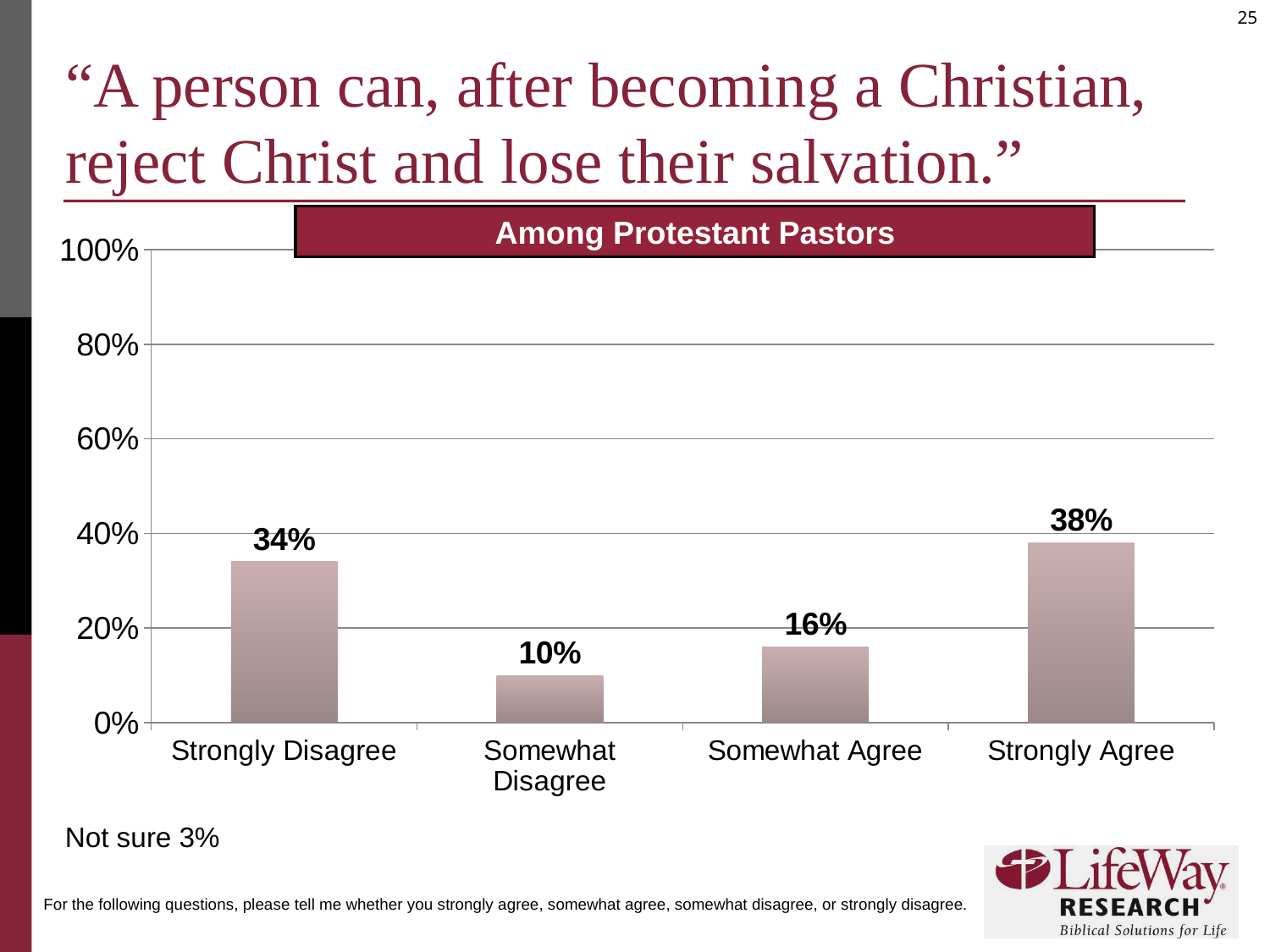
What percentage of Protestant pastors somewhat agree? 16% What kind of chart is shown on the slide? Bar chart What percentage of Protestant pastors strongly agree? 38% Which response category has the highest percentage? Strongly Agree Which response category has the lowest percentage? Somewhat Disagree How many response categories are shown on the x axis of the chart? 4 What group does the label above the chart say the results are among? Protestant Pastors What is the difference in percentage points between Strongly Agree and Strongly Disagree? 4 What percentage of Protestant pastors strongly disagree? 34% Which is larger, the value for Somewhat Agree or the value for Somewhat Disagree? Somewhat Agree What percentage of Protestant pastors somewhat disagree? 10% What percentage of pastors answered 'Not sure' according to the note below the chart? 3%